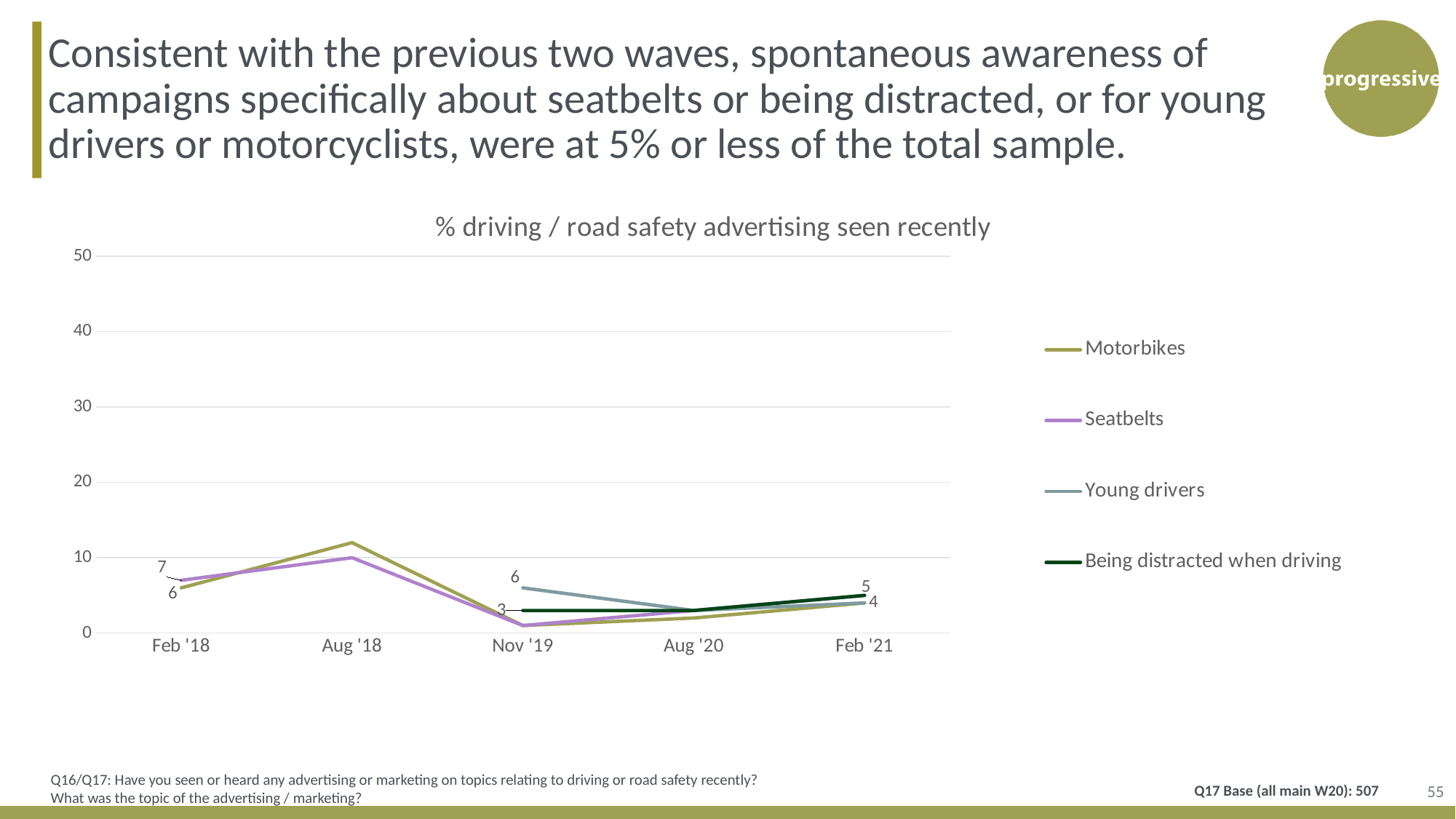
What is the value for Motorbikes in Feb '18? 6 In which wave does the Motorbikes series reach its highest value? Aug '18 What is the value for Being distracted when driving in Feb '21? 5 Which is larger for Young drivers: the value in Nov '19 or the value in Feb '21? Nov '19 By how much did the value for Being distracted when driving change between Nov '19 and Feb '21? 2 Is the value for Motorbikes in Aug '18 greater or less than 10? greater What is the value for Seatbelts in Feb '18? 7 What kind of chart is shown on the slide? Line chart How many series does the legend list? 4 What is the value for Being distracted when driving in Nov '19? 3 What is the value for Young drivers in Nov '19? 6 How many waves (time points) are shown on the x axis? 5